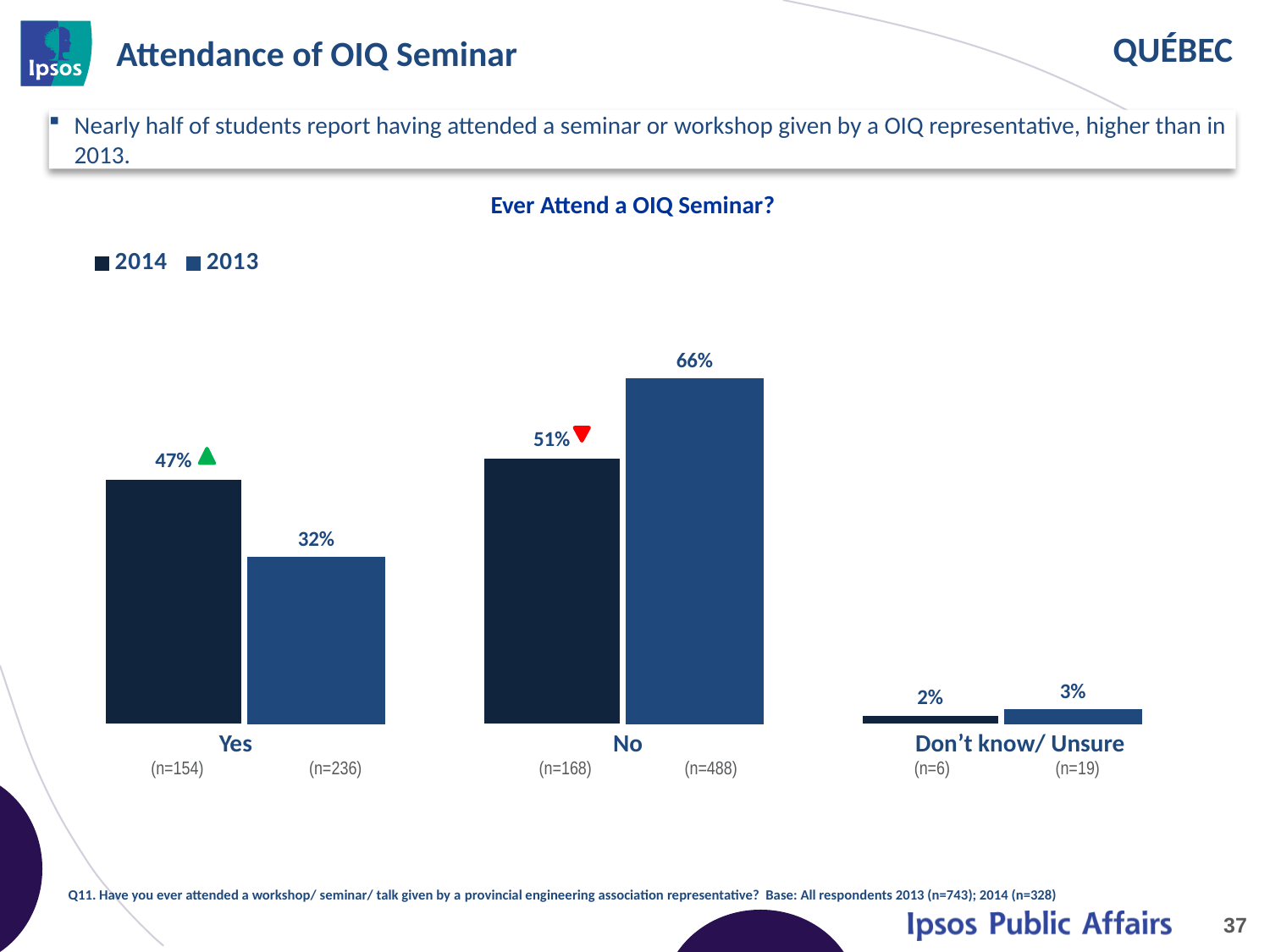
How many categories are shown on the x axis? 3 What percentage of students said No in 2013? 66% What percentage of students said Yes in 2014? 47% Which is larger, the 2014 value for Yes or the 2013 value for Yes? 2014 (47%) What is the title of the chart? Ever Attend a OIQ Seminar? What is the difference between the 2013 and 2014 values for No? 15 percentage points What is the 2014 value for Don't know/ Unsure? 2% Which category has the lowest value for 2014? Don't know/ Unsure What kind of chart is shown on the slide? Bar chart How many series does the legend list? 2 What is the difference between the 2014 and 2013 values for Yes? 15 percentage points Which category has the highest value for 2013? No